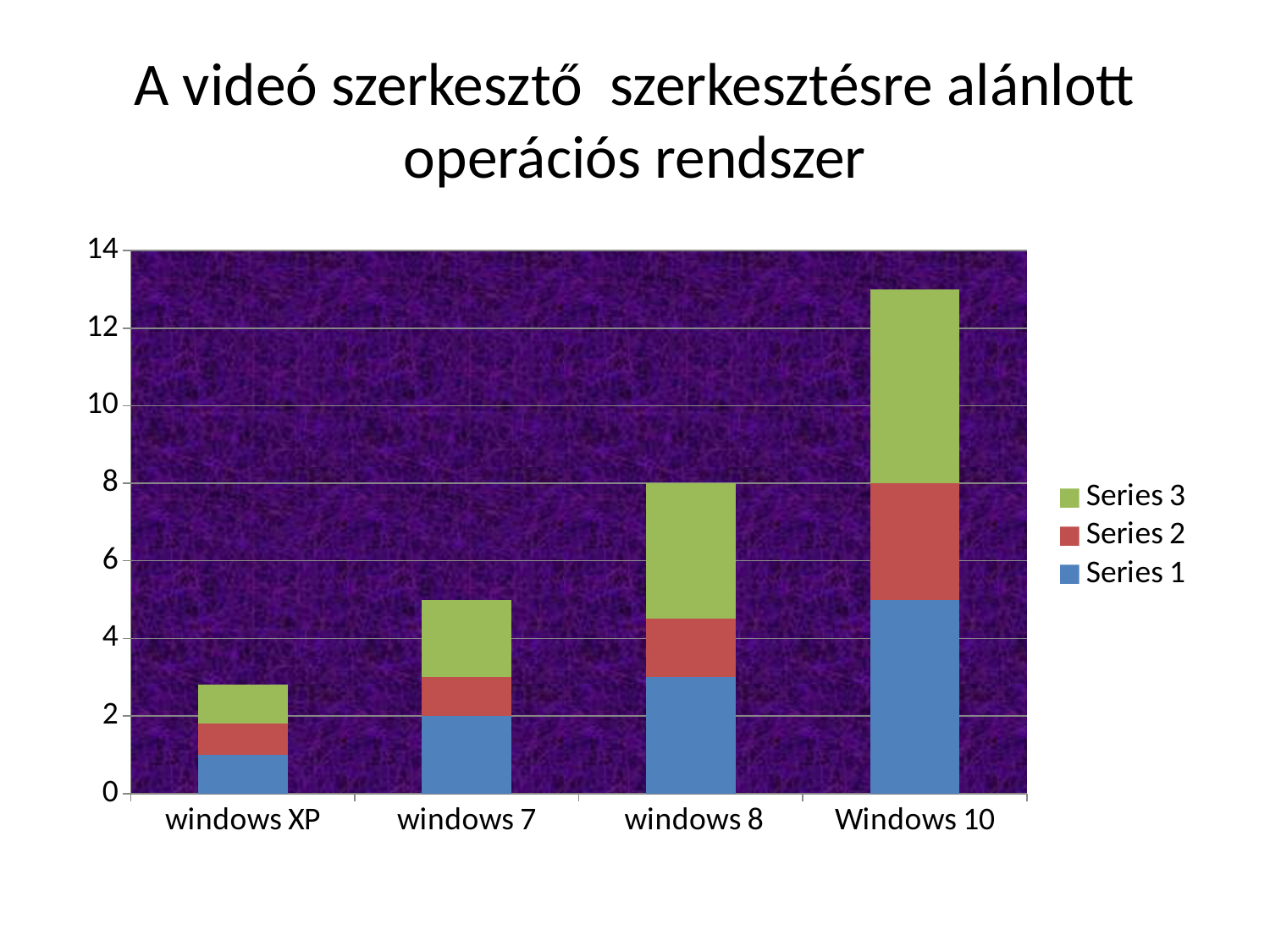
What is the total height of the stacked bar for windows 8? 8 What is the Series 1 value for windows 7? 2 Which category has the lowest total stacked bar? windows XP What kind of chart is shown on the slide? bar chart Do the total bar heights rise or fall from windows XP to Windows 10 along the x axis? rise How many operating system categories are shown on the x axis? 4 Is the Series 1 value for Windows 10 greater or less than 4? greater How many series does the legend list? 3 Which category has the highest total stacked bar? Windows 10 Which has the larger total stacked bar, windows 7 or windows 8? windows 8 Is the total stacked bar for Windows 10 greater or less than 12? greater Is the total stacked bar for windows XP greater or less than 4? less